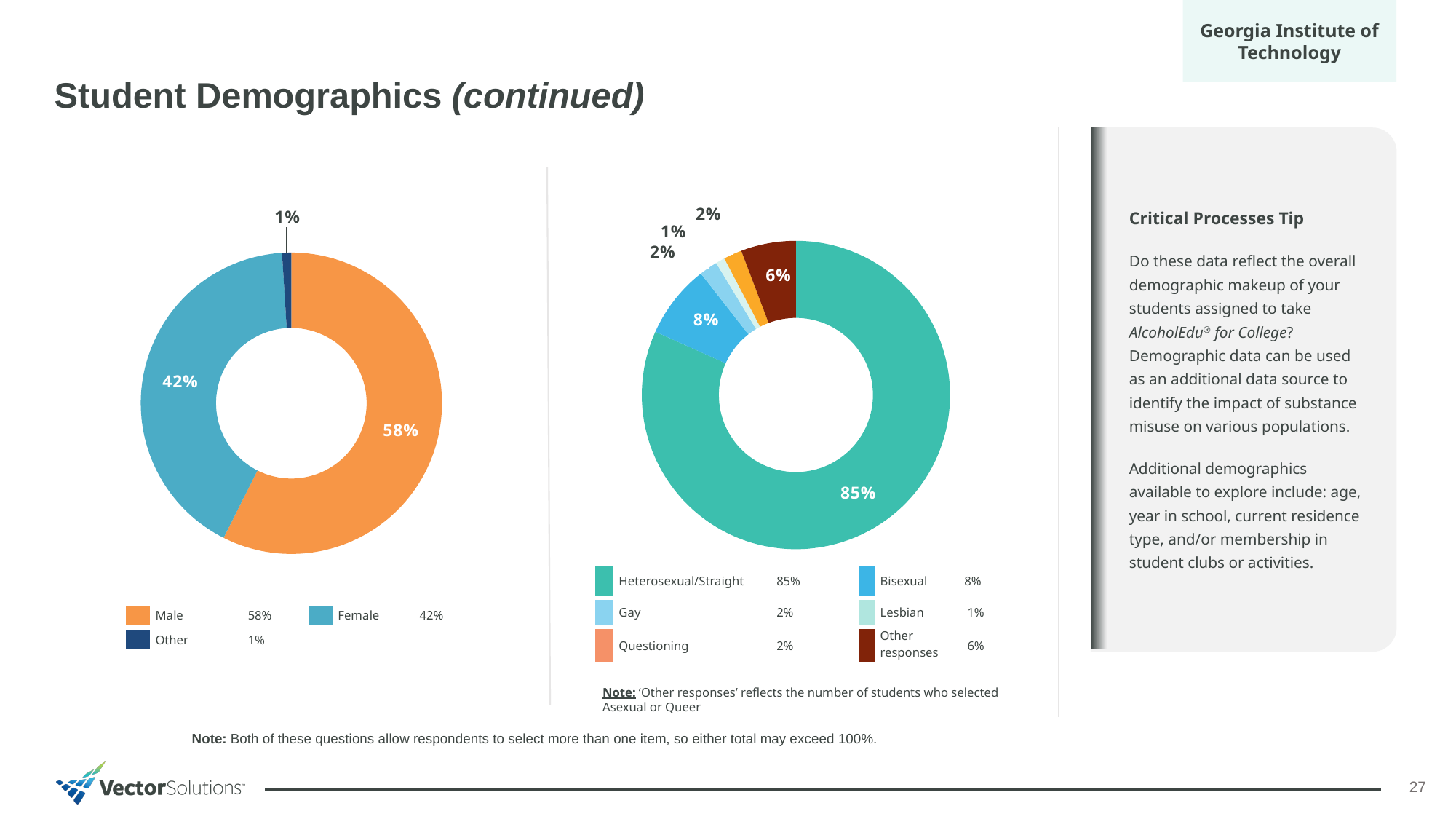
On the left chart, which category has the smallest share? Other On the right chart, which category has the largest share? Heterosexual/Straight On the right chart, which is larger, Bisexual or Other responses? Bisexual On the right chart, what percentage of students are Heterosexual/Straight? 85% On the left chart, how many categories does the legend list? 3 On the left chart, what is the difference between the Male and Female percentages? 16% On the right chart, how many categories does the legend list? 6 On the right chart, what percentage is shown for Other responses? 6% On the left chart, what percentage of students are Female? 42% On the left chart, what percentage of students are Male? 58% On the right chart, what percentage of students are Bisexual? 8% What type of chart is the left chart? Donut (pie) chart